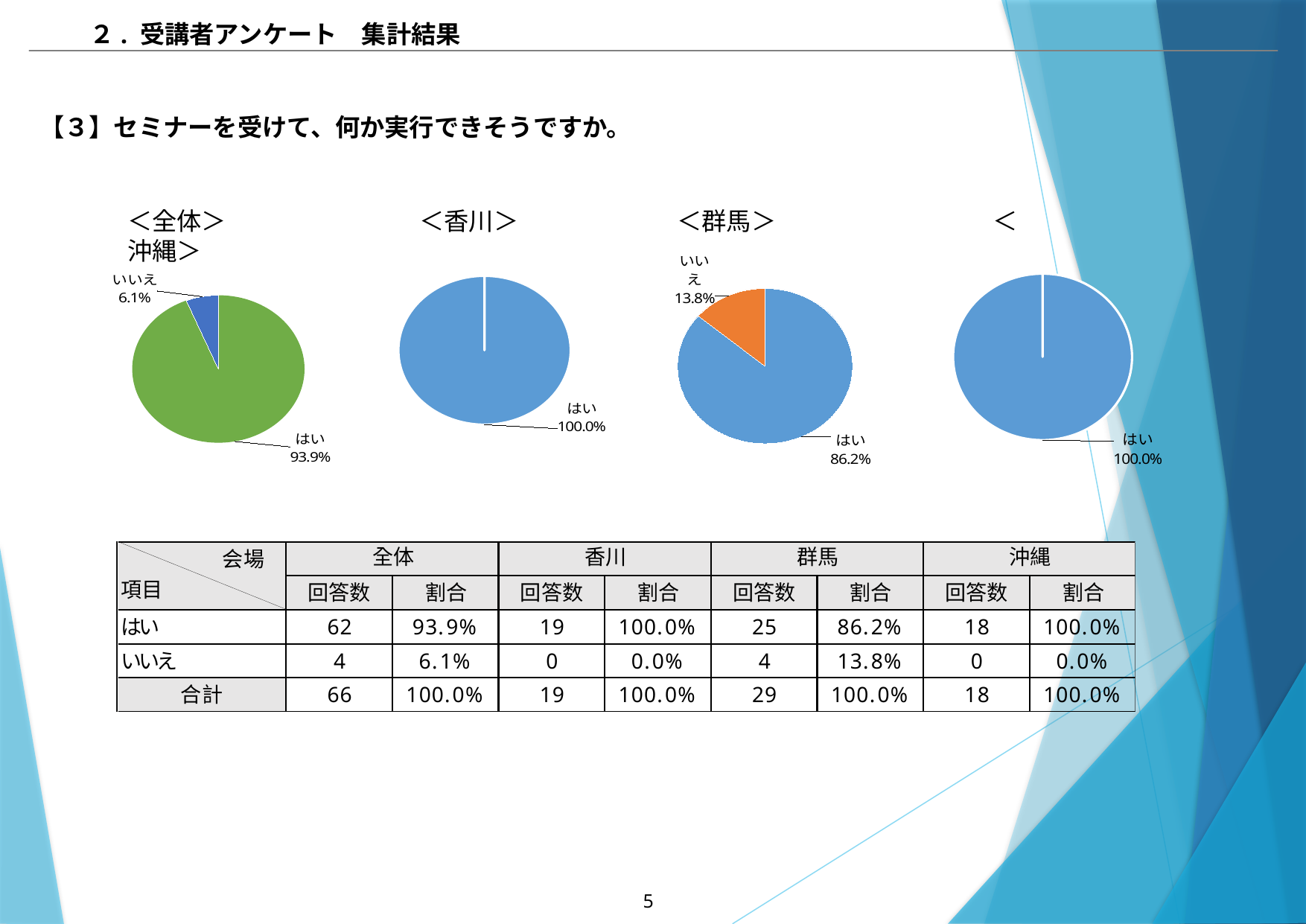
In the ＜群馬＞ pie chart, what colour is the いいえ slice? Orange In the ＜全体＞ pie chart, what share is labelled for はい? 93.9% In the ＜群馬＞ pie chart, which slice is larger, はい or いいえ? はい In the ＜全体＞ pie chart, what share is labelled for いいえ? 6.1% In the ＜群馬＞ pie chart, what share is labelled for はい? 86.2% In the ＜群馬＞ pie chart, what share is labelled for いいえ? 13.8% In the ＜香川＞ pie chart, what share is labelled for はい? 100.0% How many labelled slices does the ＜群馬＞ pie chart have? 2 In the ＜全体＞ pie chart, which slice is the smallest? いいえ What kind of chart is the ＜香川＞ chart? Pie chart How many pie charts are shown on the slide? 4 In the ＜群馬＞ pie chart, what is the difference between the はい share and the いいえ share? 72.4%